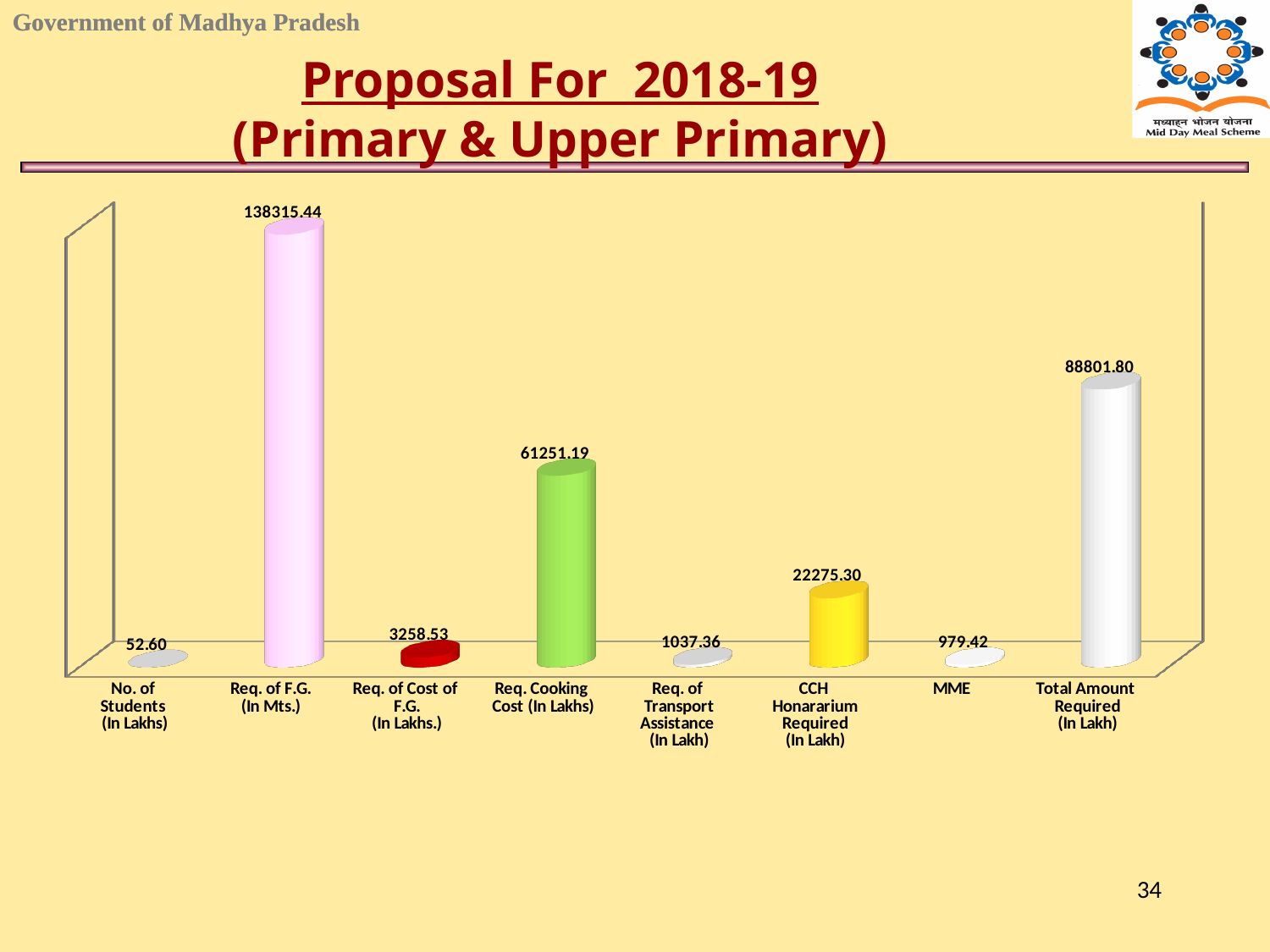
What is the value for MME? 979.42 What is the value for Req. of F.G. (In Mts.)? 138315.44 What is the value for CCH Honararium Required (In Lakh)? 22275.30 Which category has the lowest value? No. of Students (In Lakhs) What kind of chart is shown on the slide? Bar chart Which is larger: Req. of Cost of F.G. (In Lakhs.) or Req. of Transport Assistance (In Lakh)? Req. of Cost of F.G. (In Lakhs.) How many categories are shown in the chart? 8 What is the value for Req. Cooking Cost (In Lakhs)? 61251.19 What colour is the bar for Req. Cooking Cost (In Lakhs)? Green Which category has the highest value? Req. of F.G. (In Mts.) What is the value for Total Amount Required (In Lakh)? 88801.80 What is the difference between Req. of F.G. (In Mts.) and Total Amount Required (In Lakh)? 49513.64